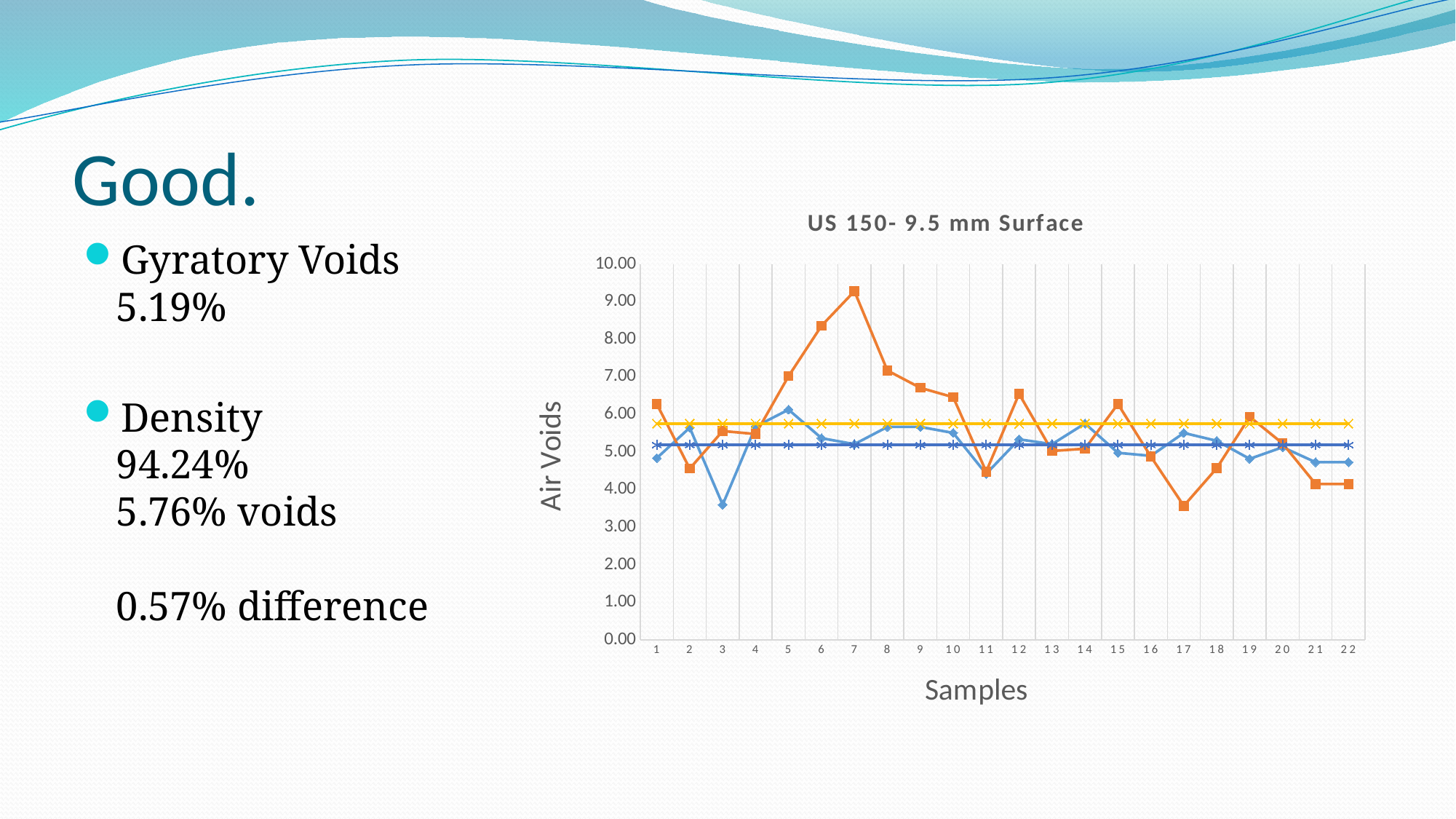
Is the value of the orange square-marker series at sample 7 greater or less than 9.00? greater What is the label of the vertical axis of the chart? Air Voids At which sample does the orange square-marker series reach its lowest value? 17 What type of chart is shown on the slide? line chart At which sample does the orange square-marker series reach its highest value? 7 How many samples are plotted along the x axis of the chart? 22 At which sample does the blue diamond-marker series reach its highest value? 5 Is the value of the blue diamond-marker series at sample 3 greater or less than 4.00? less What is the title of the chart? US 150- 9.5 mm Surface Is the value of the orange square-marker series at sample 17 greater or less than 4.00? less At which sample does the blue diamond-marker series reach its lowest value? 3 At sample 7, which series has the larger value, the orange square-marker series or the blue diamond-marker series? orange square-marker series